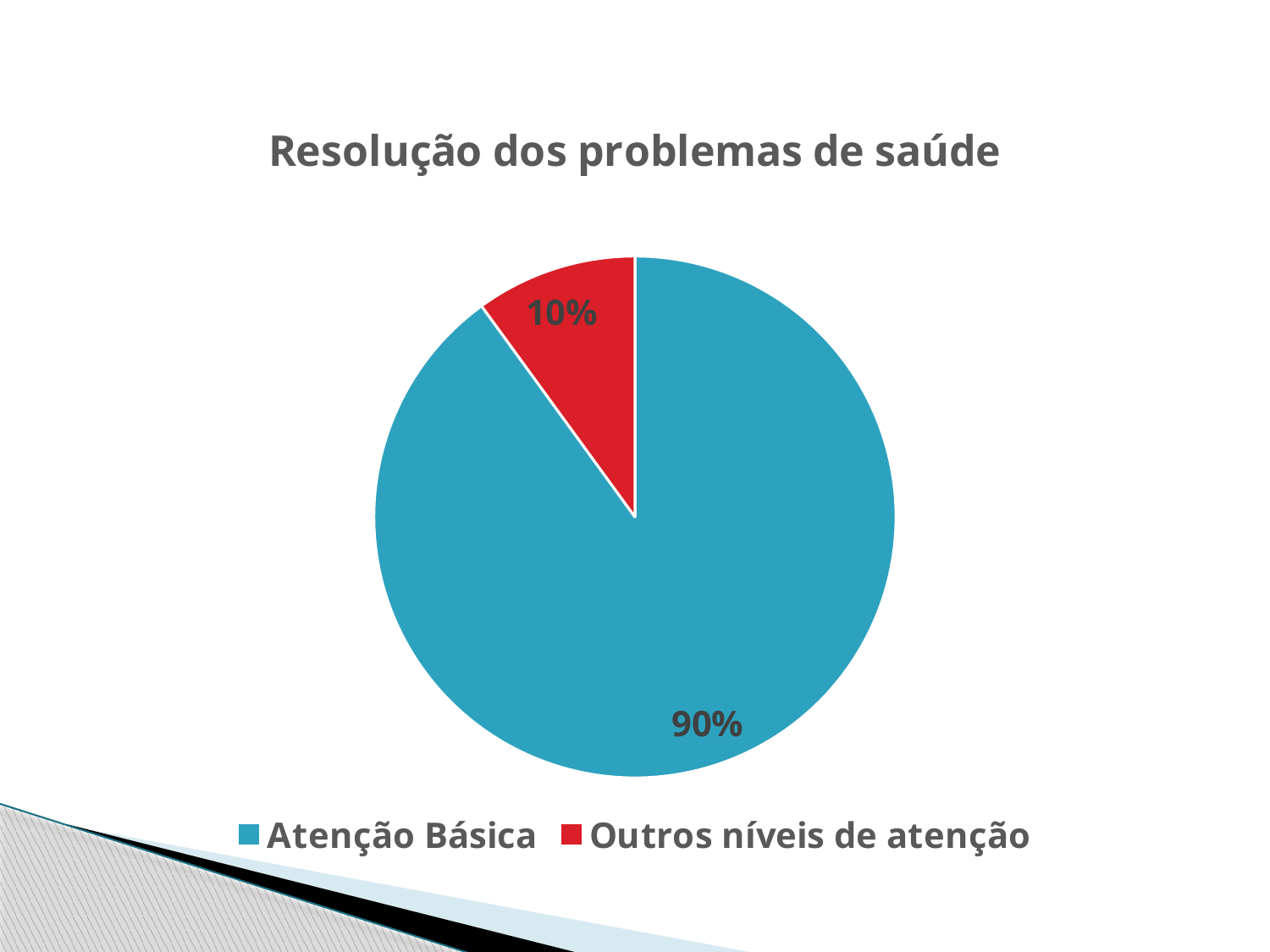
How many entries does the legend list? 2 What colour is the slice for Outros níveis de atenção? red Which is larger, the slice for Atenção Básica or the slice for Outros níveis de atenção? Atenção Básica What kind of chart is shown on the slide? pie chart How many slices does the pie chart have? 2 What share of the pie does Outros níveis de atenção represent? 10% What share of the pie does Atenção Básica represent? 90% What is the difference in percentage points between Atenção Básica and Outros níveis de atenção? 80 What is the title of the chart? Resolução dos problemas de saúde Which category has the smallest slice of the pie? Outros níveis de atenção Which category has the largest slice of the pie? Atenção Básica